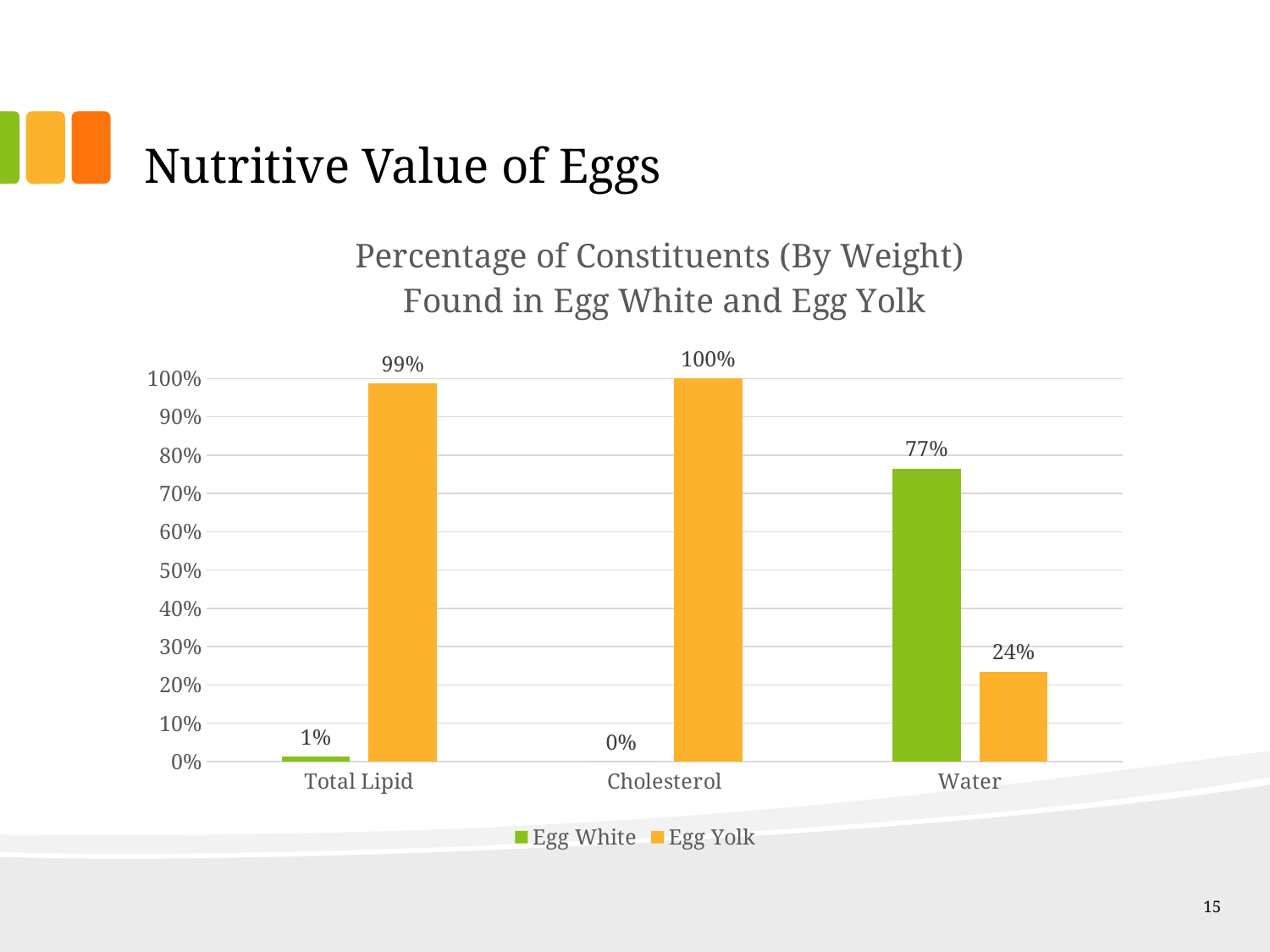
What kind of chart is shown on the slide? Bar chart What is the Egg White value for Cholesterol? 0% Which category has the highest Egg Yolk value? Cholesterol How many categories are shown on the x axis? 3 What is the Egg Yolk value for Total Lipid? 99% What is the Egg White value for Water? 77% What is the Egg Yolk value for Water? 24% What is the difference between the Egg White and Egg Yolk values for Water? 53% Which category has the lowest Egg White value? Cholesterol For Total Lipid, which is larger: the Egg White value or the Egg Yolk value? Egg Yolk How many series does the legend list? 2 What colour represents Egg Yolk in the chart? Orange